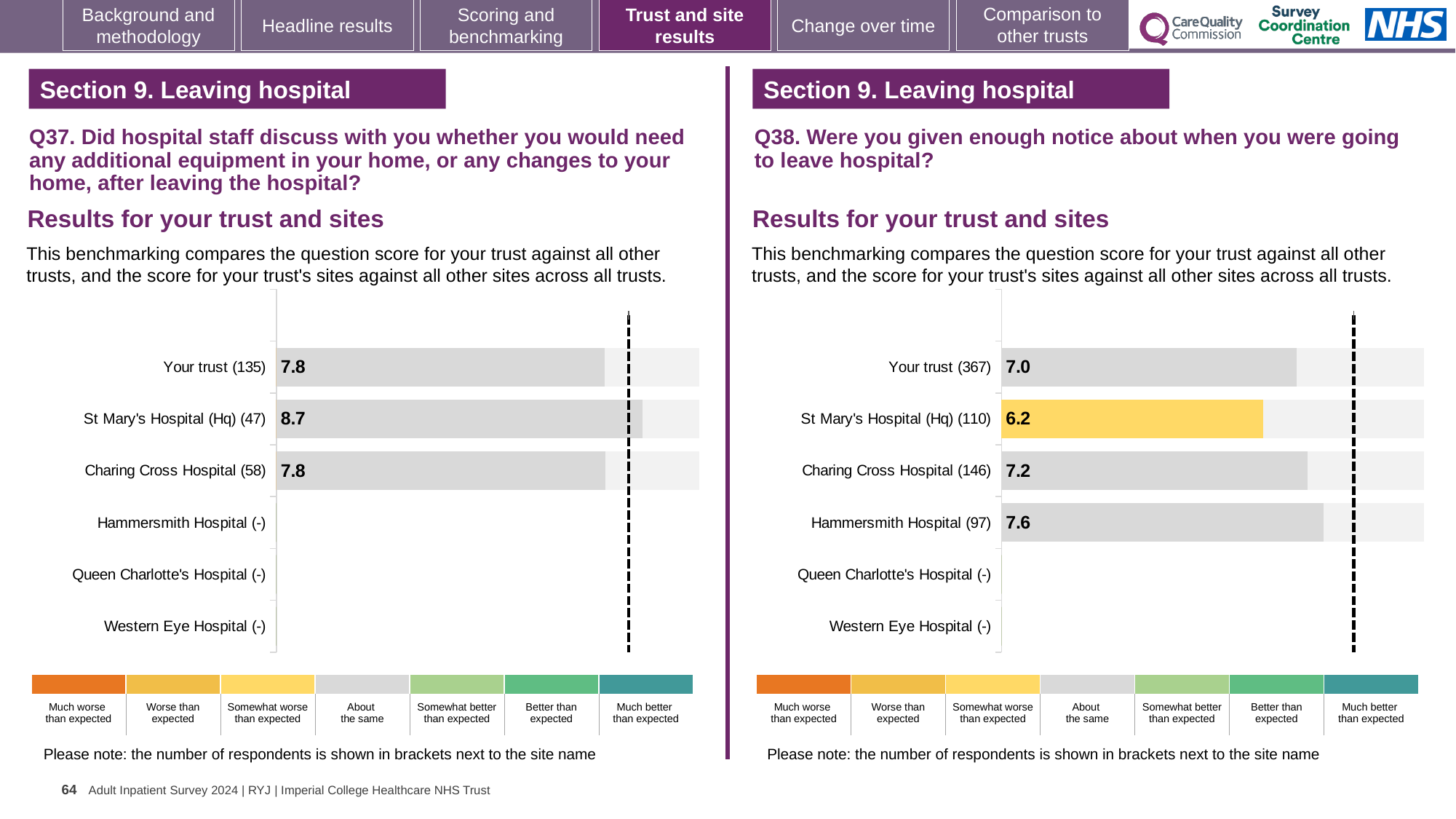
In the Q38 chart on the right, how many respondents are shown in brackets for Your trust? 367 In the Q38 chart on the right, what is the score for St Mary's Hospital (Hq)? 6.2 In the Q37 chart on the left, what is the difference between the scores for St Mary's Hospital (Hq) and Charing Cross Hospital? 0.9 What kind of chart is used on the left for Q37? Bar chart In the Q37 chart on the left, which site has the highest score? St Mary's Hospital (Hq) In the Q38 chart on the right, which has the higher score, Charing Cross Hospital or Hammersmith Hospital? Hammersmith Hospital In the Q38 chart on the right, which benchmark category does the colour of the St Mary's Hospital (Hq) bar indicate? Somewhat worse than expected In the Q38 chart on the right, what is the difference between the scores for Hammersmith Hospital and Your trust? 0.6 In the Q38 chart on the right, what is the score for Hammersmith Hospital? 7.6 In the Q38 chart on the right, which site has the lowest score? St Mary's Hospital (Hq) In the Q37 chart on the left, what is the score for St Mary's Hospital (Hq)? 8.7 In the Q37 chart on the left, what is the score for Your trust? 7.8